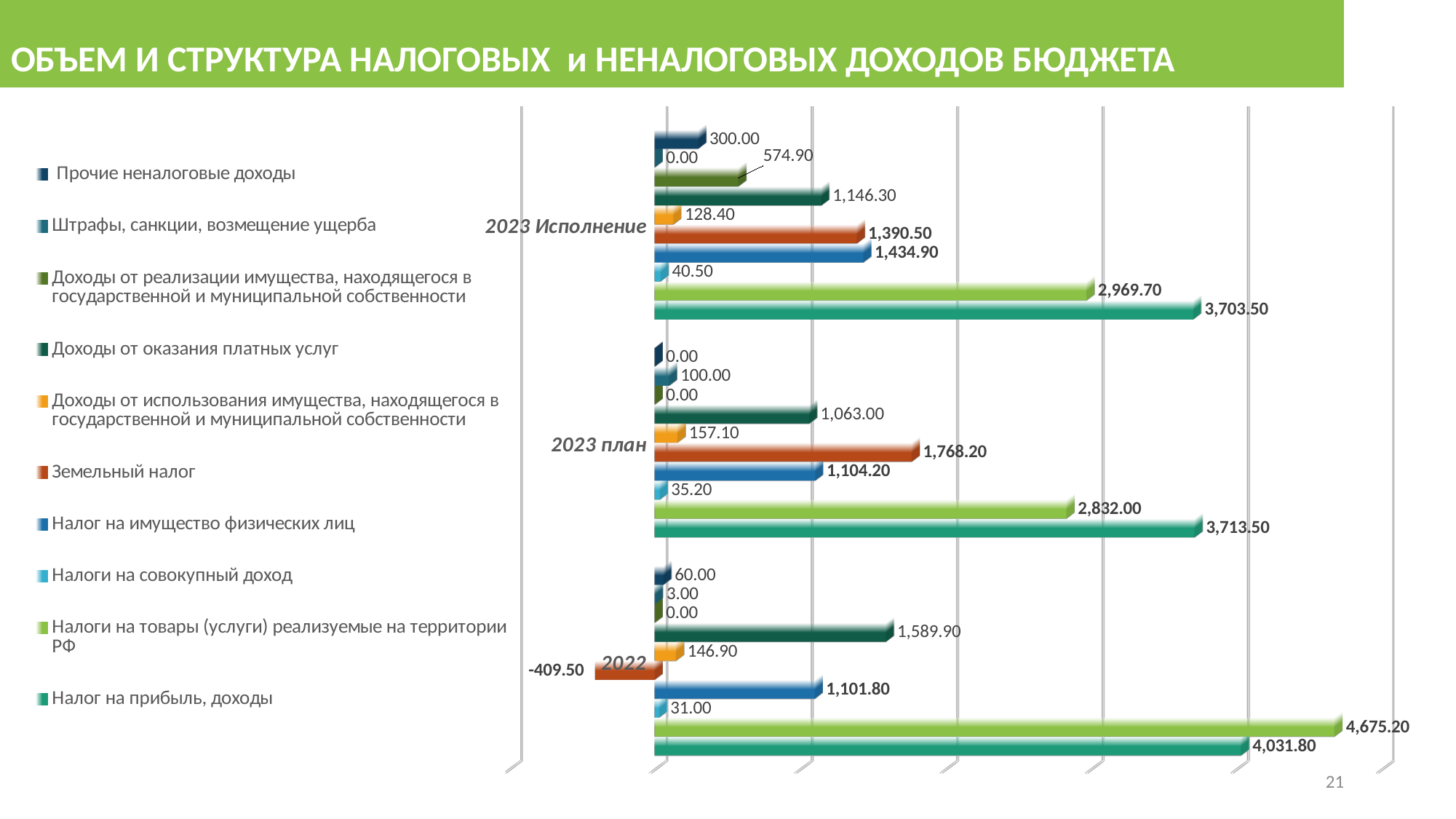
What is the value of Доходы от оказания платных услуг for 2022? 1,589.90 What is the value of Налоги на товары (услуги) реализуемые на территории РФ for 2023 план? 2,832.00 What is the difference between Налог на прибыль, доходы for 2023 план and for 2023 Исполнение? 10.00 Which series has the lowest value in the 2022 group? Земельный налог What is the difference between Налоги на товары (услуги) реализуемые на территории РФ for 2022 and for 2023 Исполнение? 1,705.50 How many category groups (periods) are shown on the chart? 3 Which series has the highest value in the 2022 group? Налоги на товары (услуги) реализуемые на территории РФ Which is larger: Земельный налог for 2023 план or for 2023 Исполнение? 2023 план How many series does the legend list? 10 What is the value of Налог на прибыль, доходы for 2023 Исполнение? 3,703.50 What is the value of Земельный налог for 2022? -409.50 What kind of chart is shown on the slide? bar chart